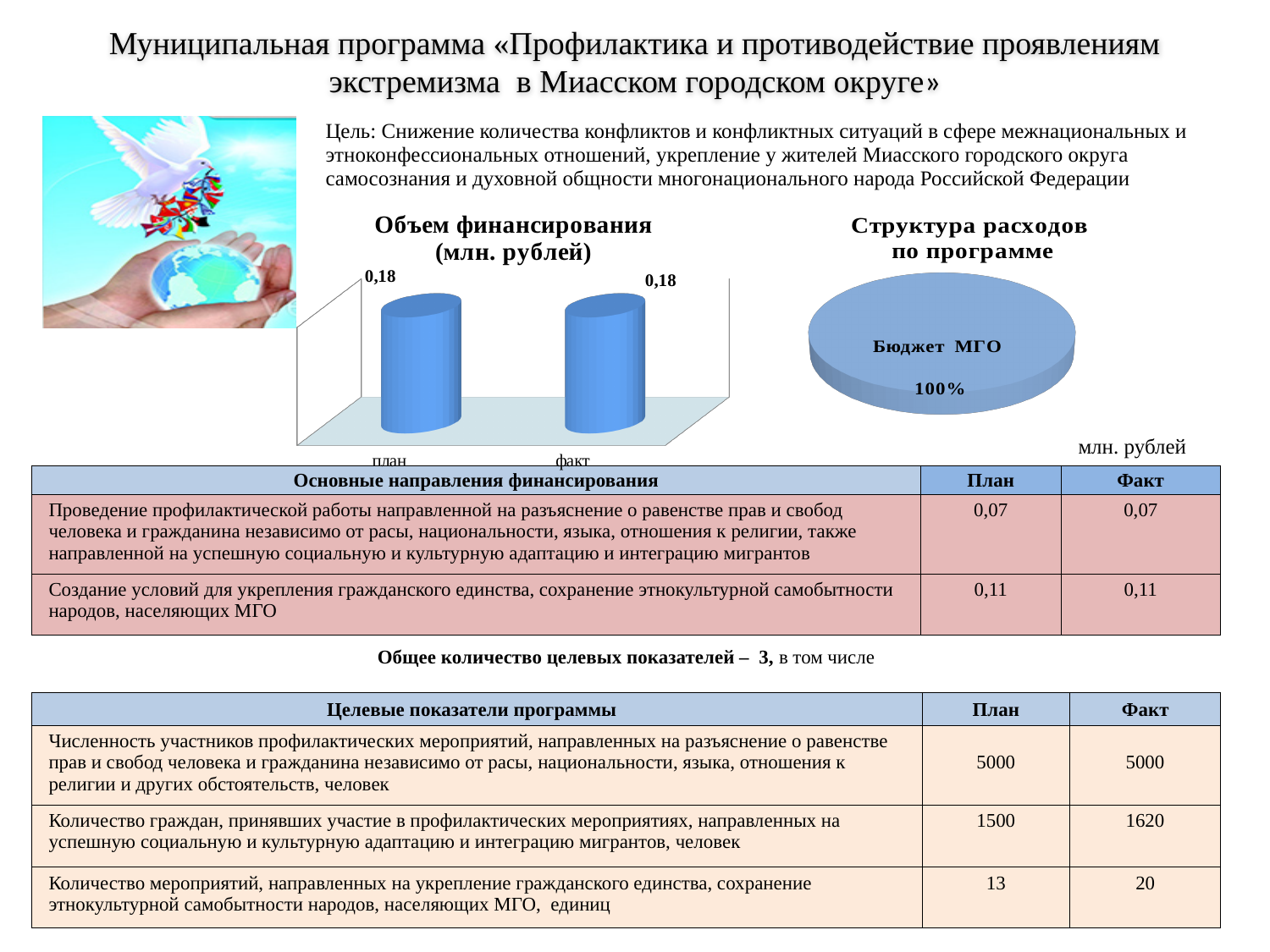
In the chart "Объем финансирования (млн. рублей)", is the value for факт greater than, less than, or equal to the value for план? equal What kind of chart is "Структура расходов по программе"? pie chart In the chart "Объем финансирования (млн. рублей)", how many bars are plotted? 2 In the pie chart "Структура расходов по программе", what share does Бюджет МГО have? 100% In the chart "Объем финансирования (млн. рублей)", what is the value for план? 0,18 In the pie chart "Структура расходов по программе", how many slices are there? 1 In the chart "Объем финансирования (млн. рублей)", what are the two category labels on the x axis? план, факт In the chart "Объем финансирования (млн. рублей)", what is the difference between the план and факт values? 0 What kind of chart is "Объем финансирования (млн. рублей)"? bar chart In the chart "Объем финансирования (млн. рублей)", what is the value for факт? 0,18 In the pie chart "Структура расходов по программе", what is the label of the only slice? Бюджет МГО